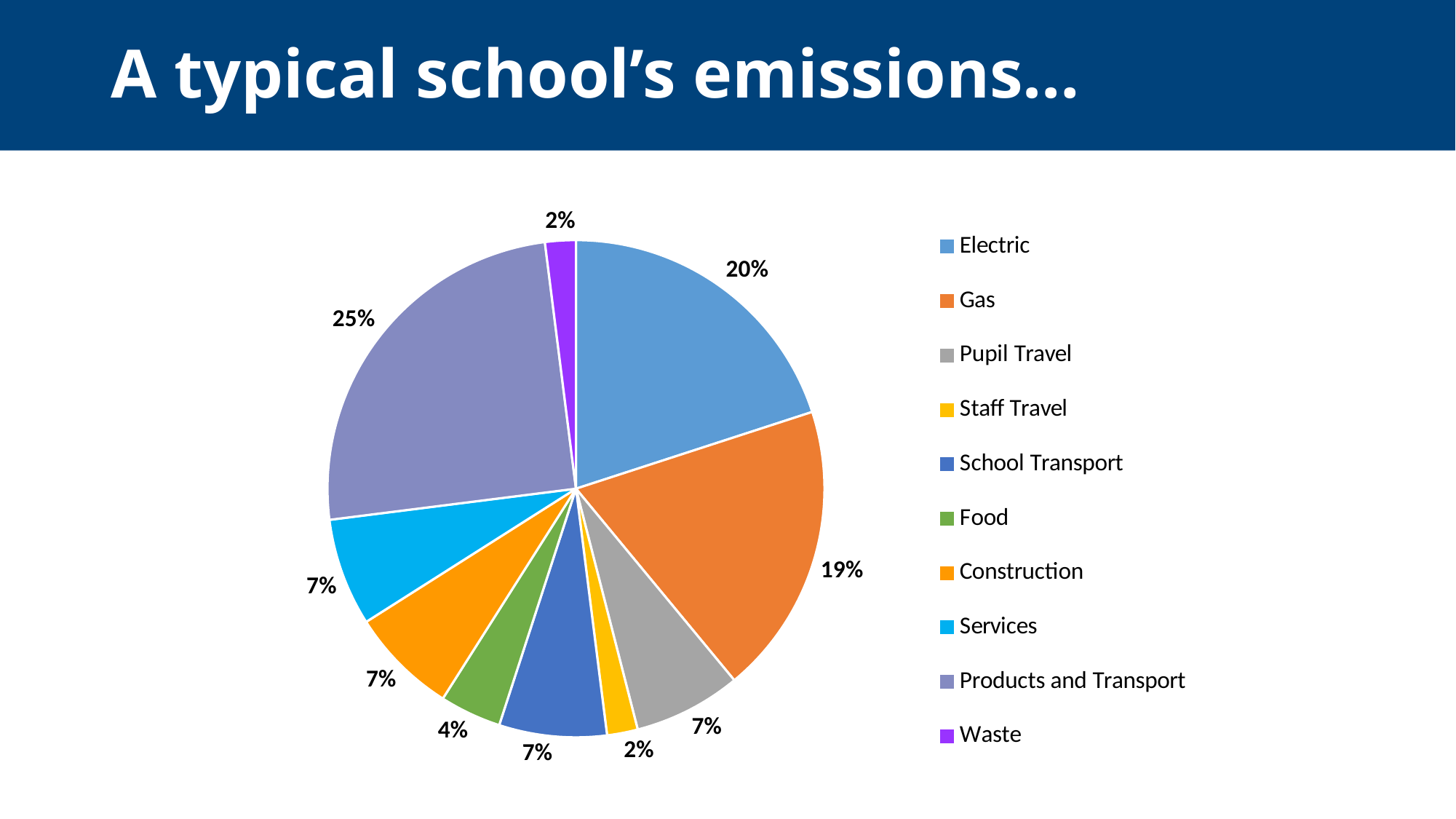
What colour is the Services slice? light blue What share of emissions does Gas account for? 19% What is the difference between the share for Products and Transport and the share for Gas? 6% What is the title of the slide? A typical school’s emissions… What kind of chart is shown on the slide? pie chart Which category has the largest share of emissions? Products and Transport What share of emissions does Food account for? 4% What share of emissions does Products and Transport account for? 25% Which is larger, the share for Products and Transport or the share for Electric? Products and Transport How many categories does the legend list? 10